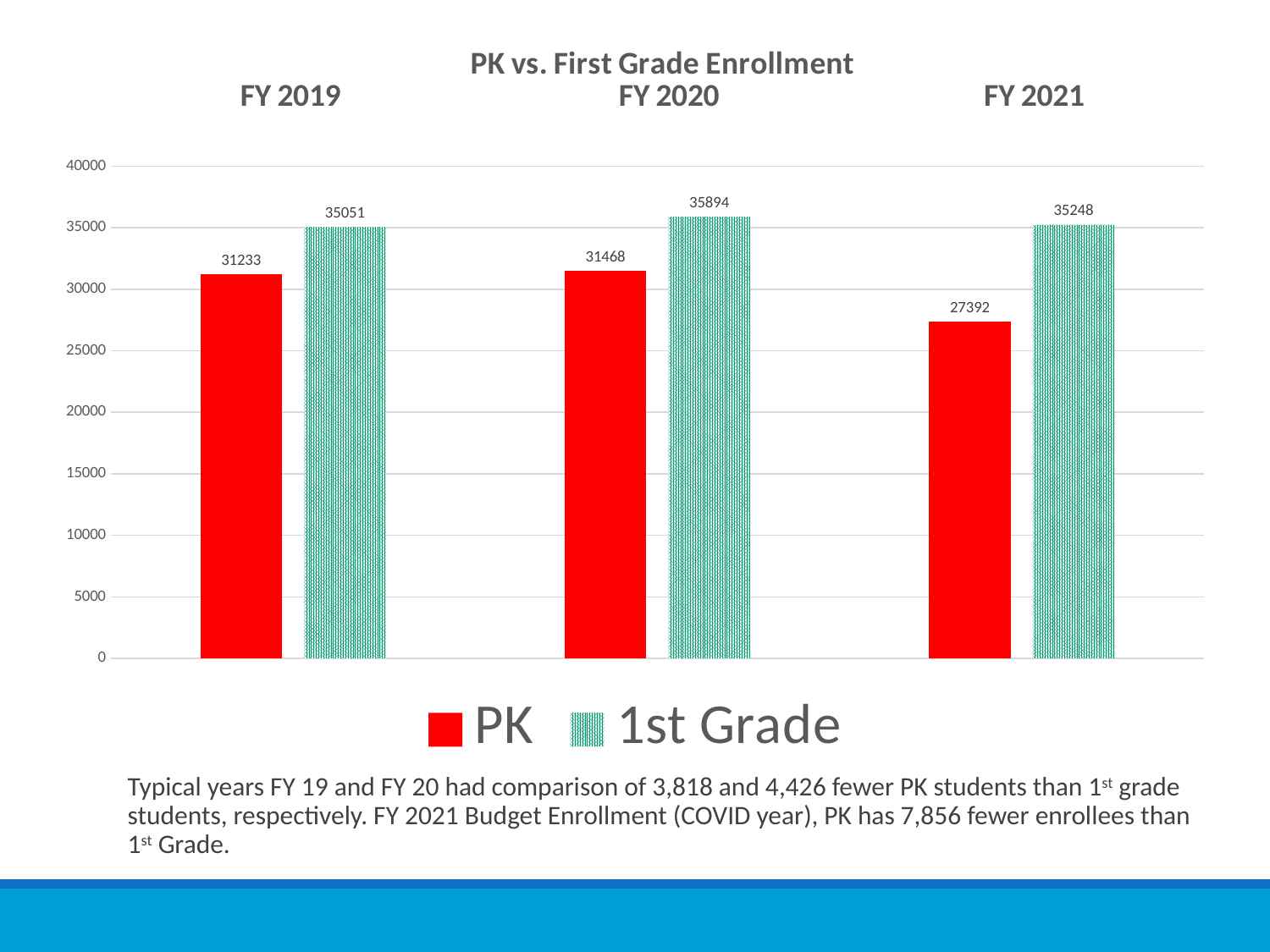
Which fiscal year has the highest 1st Grade enrollment? FY 2020 How many series does the legend list? 2 What is the difference between 1st Grade and PK enrollment in FY 2019? 3818 In FY 2020, which is larger, PK enrollment or 1st Grade enrollment? 1st Grade What is the PK enrollment for FY 2019? 31233 How many fiscal years are shown on the chart? 3 What is the PK enrollment for FY 2021? 27392 What is the 1st Grade enrollment for FY 2021? 35248 What type of chart is shown on the slide? Bar chart Which fiscal year has the lowest PK enrollment? FY 2021 What is the 1st Grade enrollment for FY 2020? 35894 What is the difference between 1st Grade and PK enrollment in FY 2021? 7856